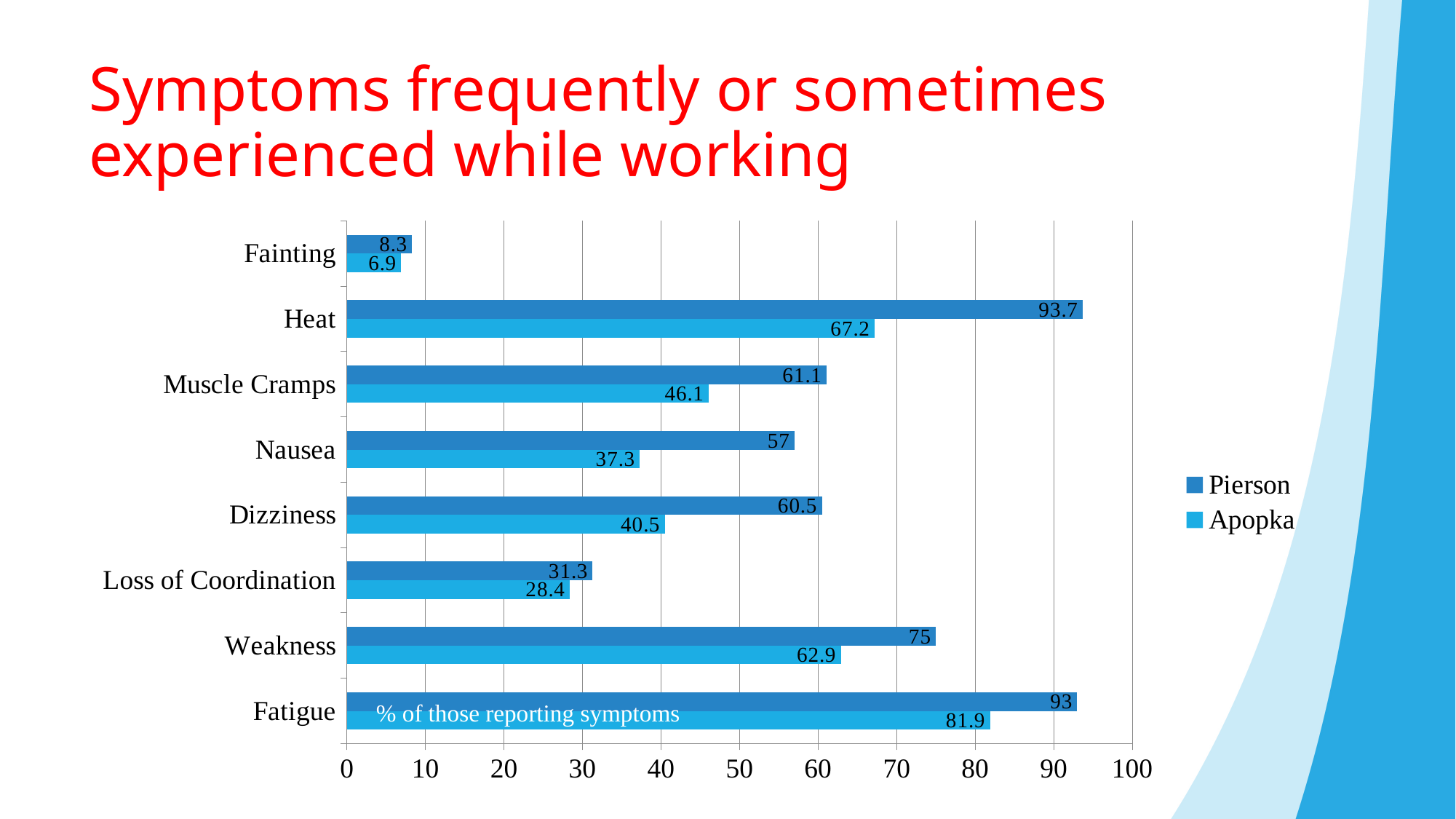
What are the two series named in the legend? Pierson and Apopka What is the Apopka value for Nausea? 37.3 Which symptom has the lowest Apopka value? Fainting Which symptom has the highest Pierson value? Heat How many symptom categories are shown on the chart? 8 What is the difference between the Pierson and Apopka values for Dizziness? 20 How many series does the legend list? 2 Which is larger for Weakness, the Pierson value or the Apopka value? Pierson What kind of chart is shown on the slide? bar chart Is the Apopka value for Muscle Cramps greater or less than 50? less What is the Pierson value for Heat? 93.7 What is the Apopka value for Fatigue? 81.9